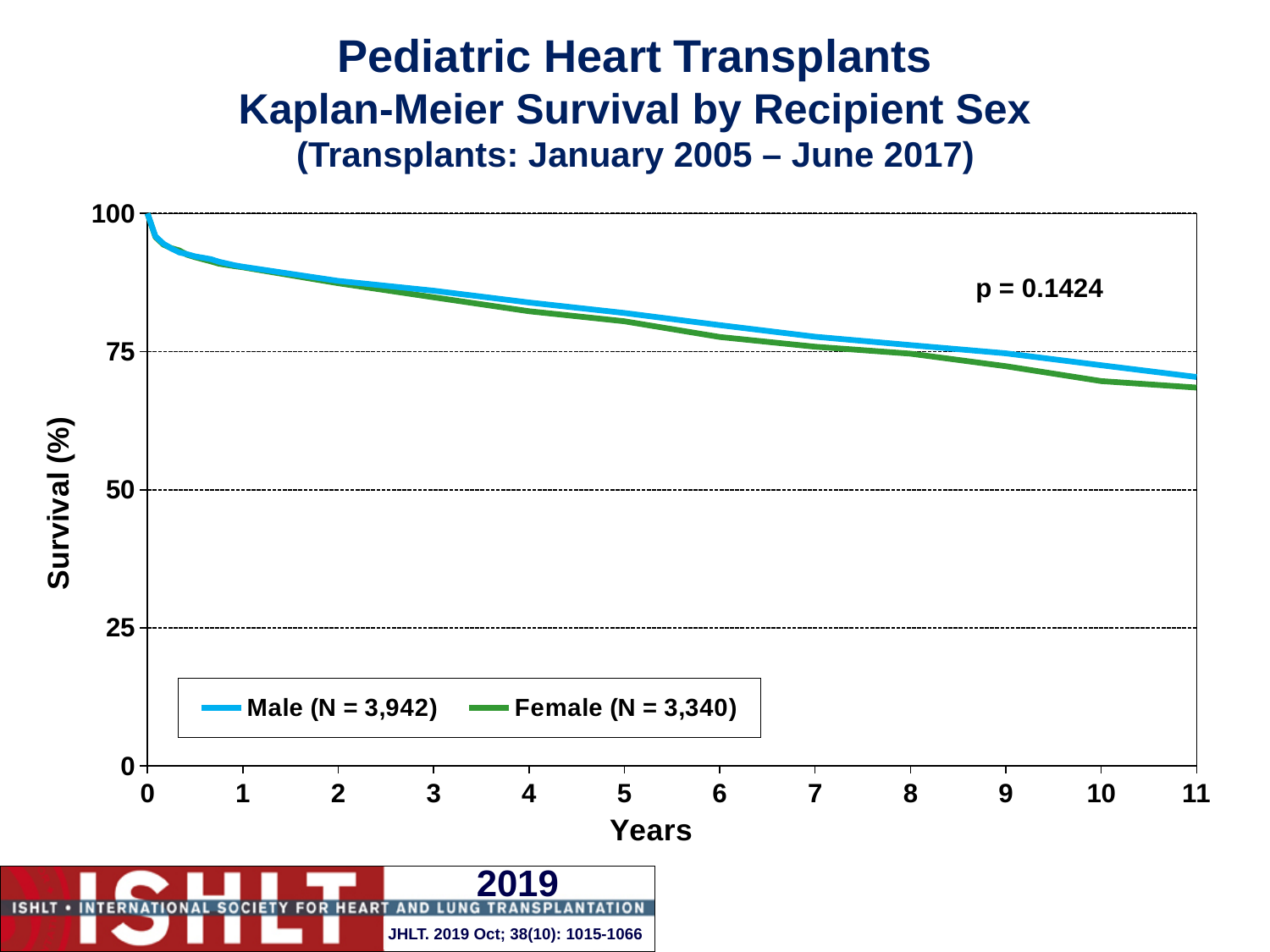
Do the survival curves rise or fall as years increase? Fall What kind of chart is shown on the slide? Line chart Is the survival for Male at 11 years greater or less than 75? less At 11 years, which series has the lower survival, Male or Female? Female Is the survival for Female at 1 year greater or less than 75? greater Is the survival for Female at 9 years greater or less than 50? greater What is the N for the Male series in the legend? 3,942 At 10 years, which series has the higher survival, Male or Female? Male What p-value is shown on the chart? p = 0.1424 How many series does the legend list? 2